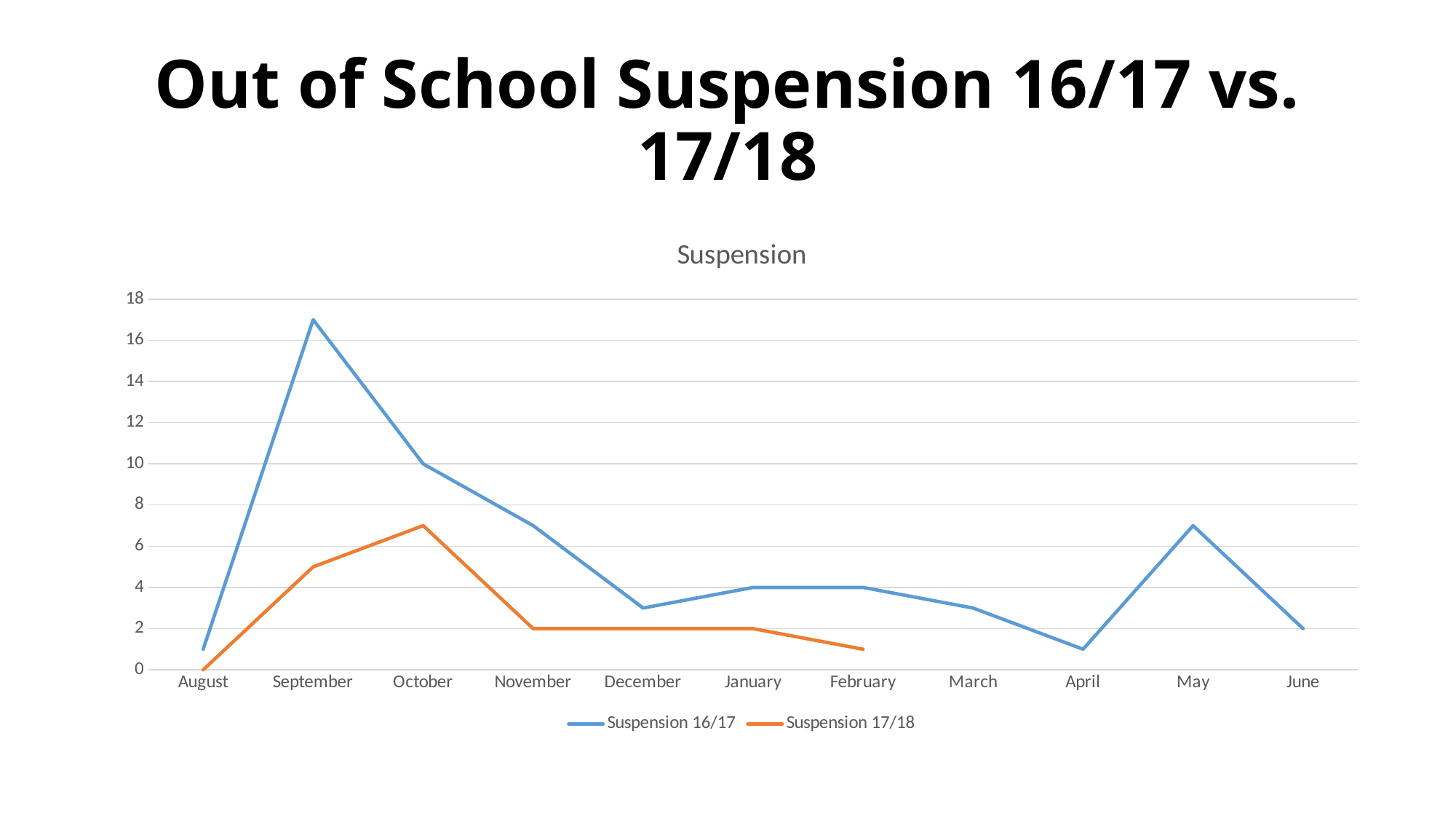
Does the Suspension 17/18 series rise or fall from October to February? fall In which month does the Suspension 17/18 series reach its highest value? October In which month is the Suspension 17/18 value lowest? August How many months are shown along the x axis? 11 Which series has the larger value in September, Suspension 16/17 or Suspension 17/18? Suspension 16/17 What is the Suspension 17/18 value for November? 2 What type of chart is shown on the slide? line chart In which month does the Suspension 16/17 series reach its highest value? September What is the difference between the Suspension 16/17 and Suspension 17/18 values in January? 2 What is the Suspension 16/17 value for October? 10 Is the Suspension 16/17 value for September greater or less than 16? greater How many series does the legend list? 2